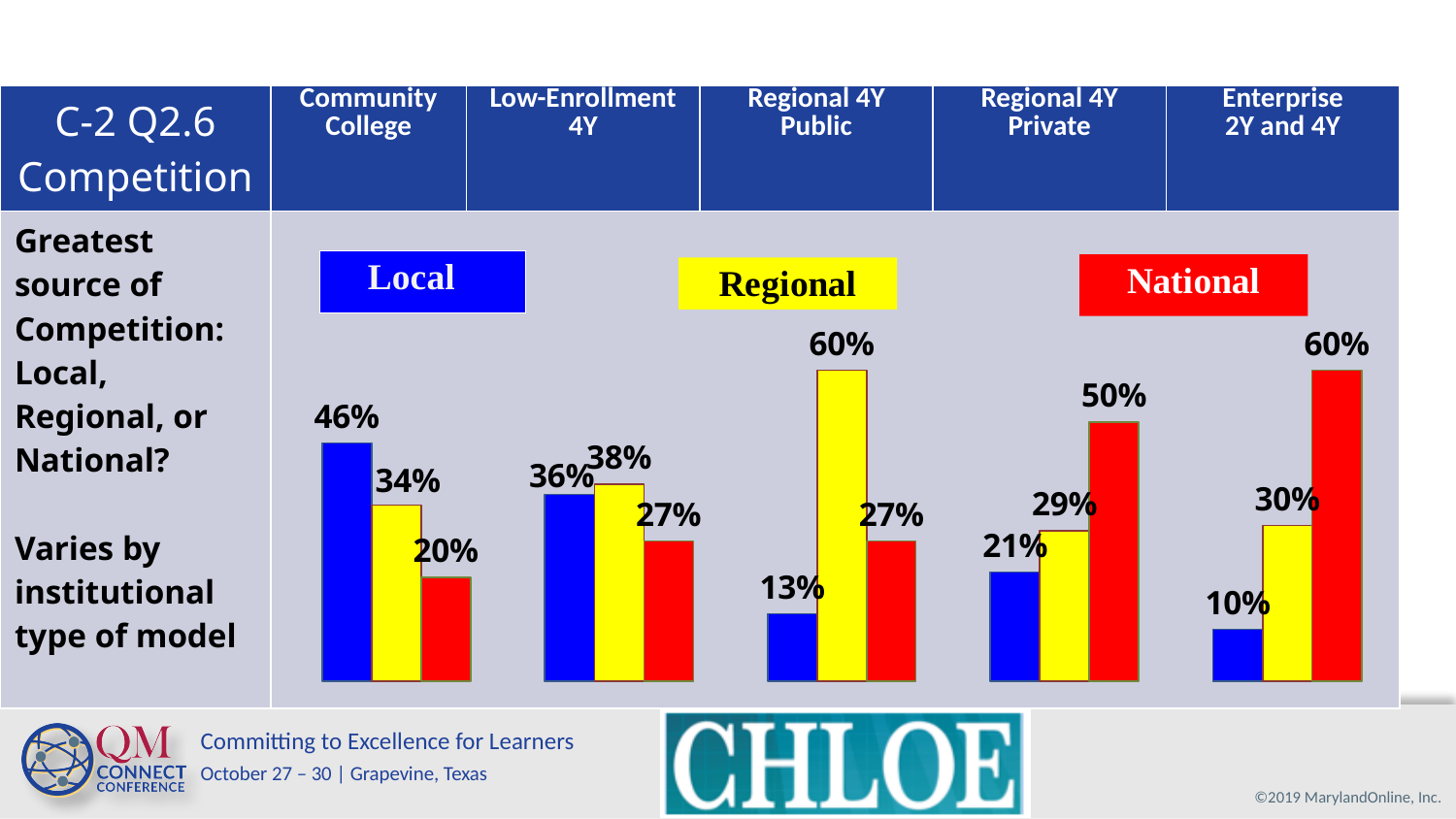
What percentage of Community Colleges report Local as their greatest source of competition? 46% What is the Local value for Enterprise 2Y and 4Y institutions? 10% Which colour represents the National series? Red What is the difference between the National and Local values for Regional 4Y Private institutions? 29% Which institutional type has the highest Local value? Community College Which institutional type has the lowest Local value? Enterprise 2Y and 4Y For Low-Enrollment 4Y institutions, which is larger: the Local value or the National value? Local What type of chart is shown on the slide? Bar chart What is the National value for Enterprise 2Y and 4Y institutions? 60% How many institutional types are shown on the chart? 5 What is the Regional value for Regional 4Y Public institutions? 60% How many series (sources of competition) does the chart show? 3